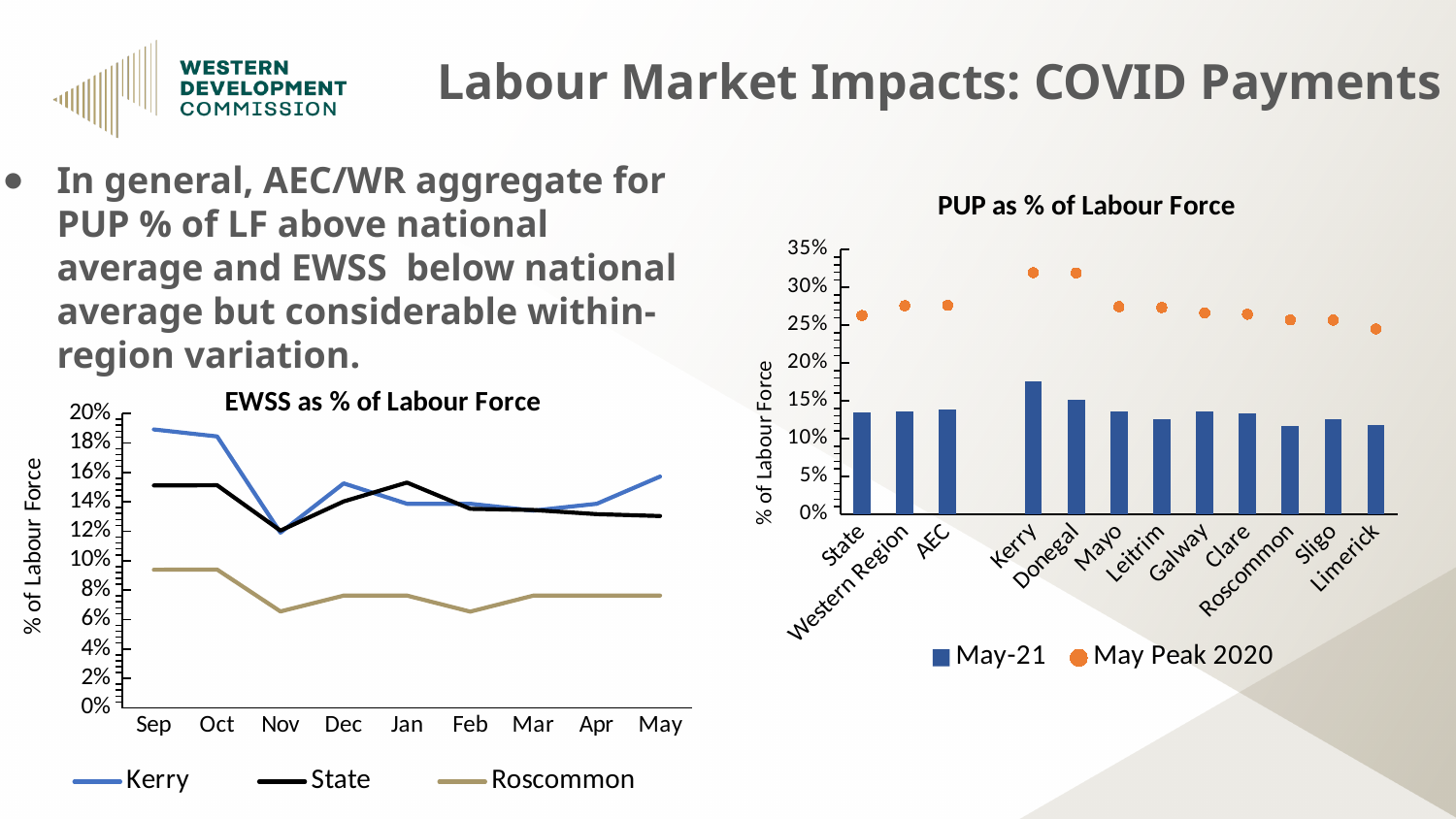
In the 'EWSS as % of Labour Force' chart, is the value for Roscommon in Nov greater or less than 8%? less In the 'PUP as % of Labour Force' chart, which category has the highest May-21 value? Kerry In the 'EWSS as % of Labour Force' chart, which series has the lowest value in Sep? Roscommon In the 'PUP as % of Labour Force' chart, is the May-21 value for Kerry greater or less than 15%? greater In the 'EWSS as % of Labour Force' chart, which is larger in Sep, Kerry or State? Kerry In the 'EWSS as % of Labour Force' chart, is the value for Kerry in Sep greater or less than 16%? greater In the 'EWSS as % of Labour Force' chart, how many series does the legend list? 3 In the 'EWSS as % of Labour Force' chart, how many months are shown on the x axis? 9 In the 'PUP as % of Labour Force' chart, how many categories are shown on the x axis? 12 In the 'PUP as % of Labour Force' chart, how many series does the legend list? 2 In the 'EWSS as % of Labour Force' chart, what kind of chart is it? line chart In the 'PUP as % of Labour Force' chart, which category has the lowest May Peak 2020 value? Limerick